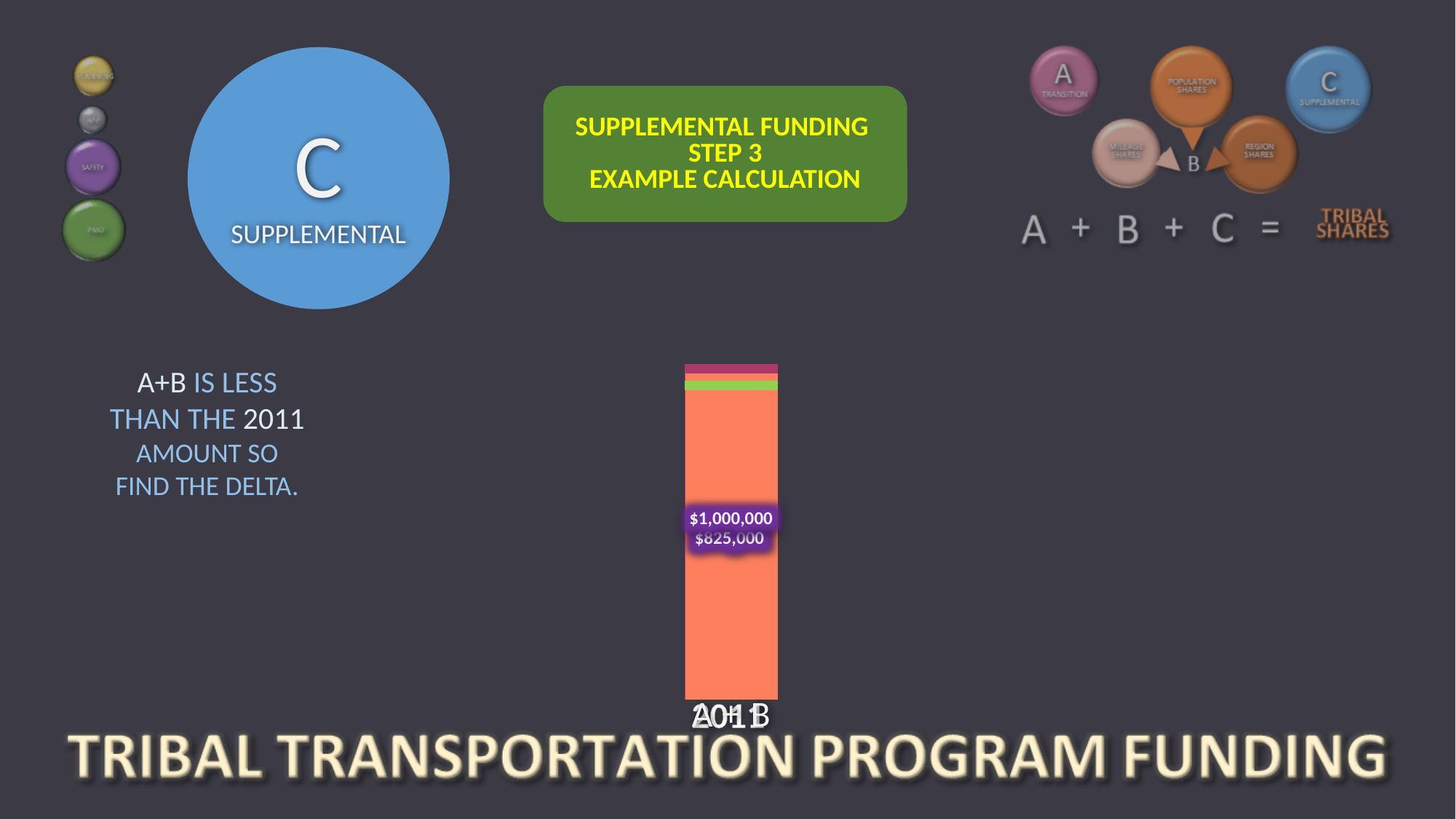
According to the slide, what is the 2011 amount shown on the bar chart? $1,000,000 What kind of chart is shown in the centre of the slide? bar chart What is the larger of the two values printed on the bar chart? $1,000,000 What is the smaller of the two values printed on the bar chart? $825,000 How many differently coloured segments make up the stacked bar on the chart? 3 What is the difference (delta) between the $1,000,000 and $825,000 values printed on the bar chart? $175,000 What is the title of the green box above the chart? SUPPLEMENTAL FUNDING STEP 3 EXAMPLE CALCULATION What colour is the largest segment of the stacked bar? orange According to the slide, what is the A+B amount shown on the bar chart? $825,000 Which is larger on the bar chart, the 2011 amount or the A+B amount? 2011